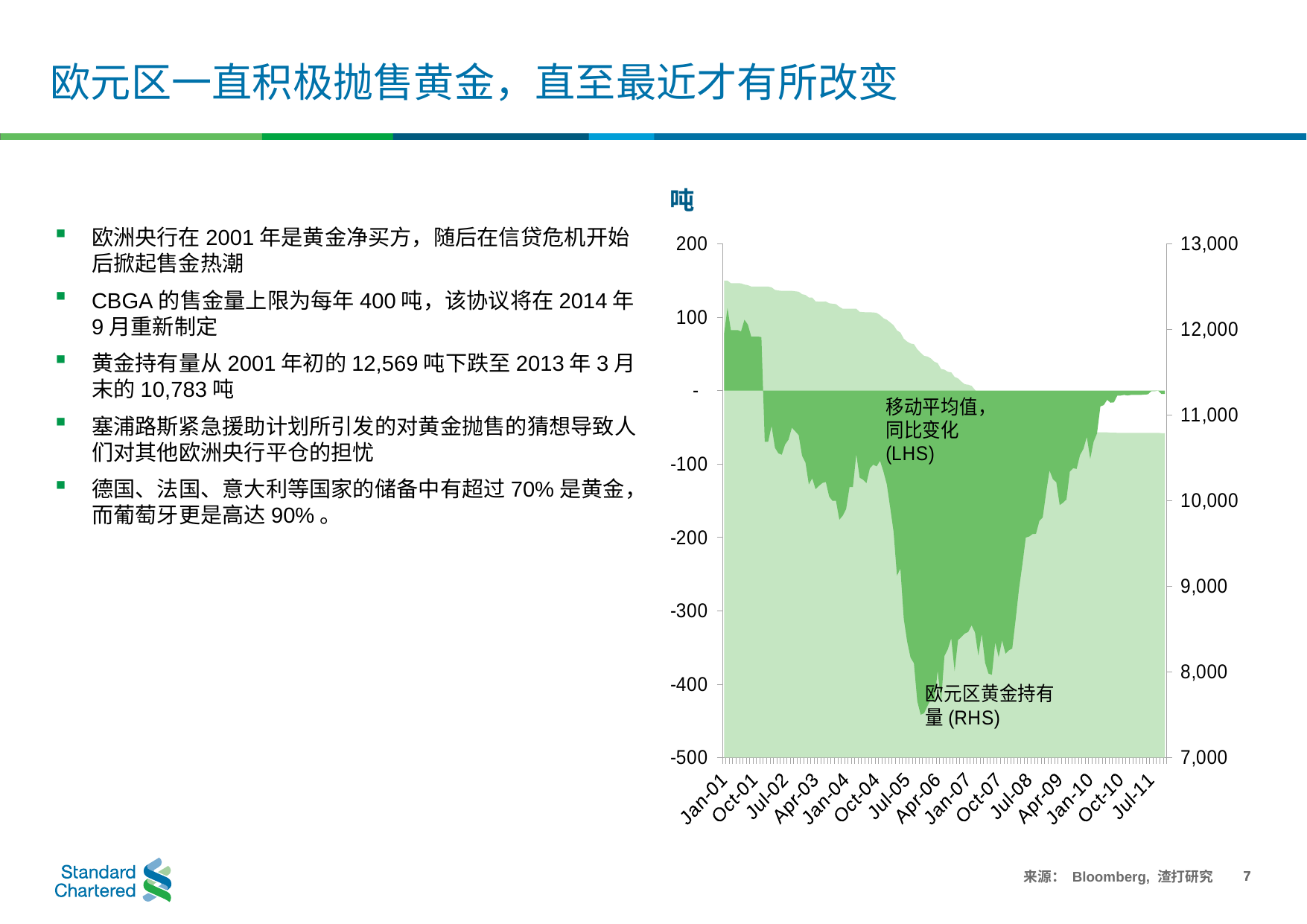
Is the moving average year-on-year change (LHS) at Jan-01 greater or less than 0? greater Which series is plotted on the right-hand axis (RHS)? 欧元区黄金持有量 How many date labels are shown on the x axis? 15 What kind of chart is shown on the slide? Area chart What unit label is shown above the chart? 吨 Is the Eurozone gold holdings value (RHS) at Jul-11 greater or less than 11,000? less How many data series are plotted in the chart? 2 Is the Eurozone gold holdings value (RHS) at Jan-01 greater or less than 12,000? greater Does the Eurozone gold holdings series (RHS) rise or fall from Jan-01 to Jul-11? Fall What is the lowest tick value shown on the left-hand axis? -500